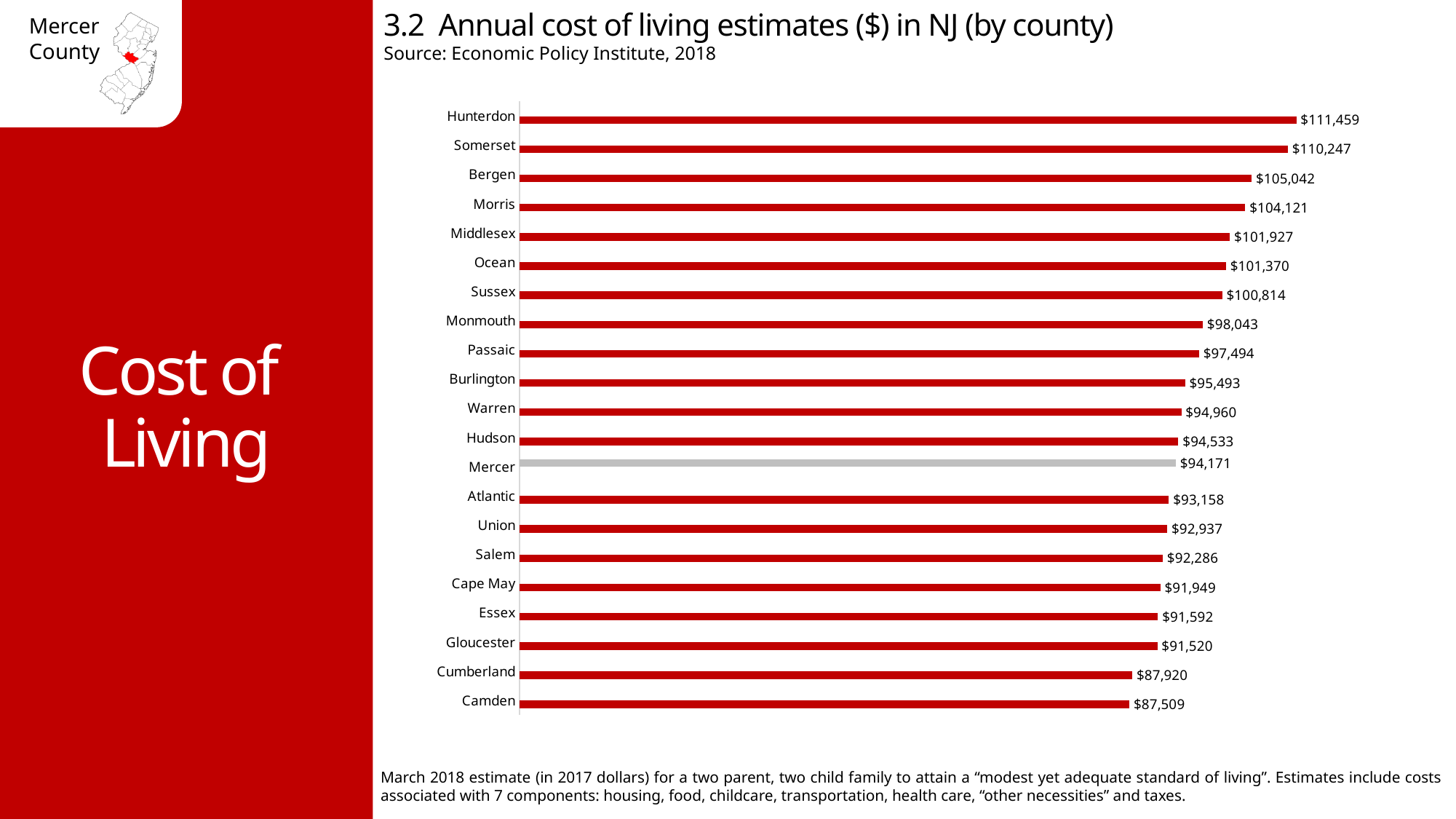
Which county's bar is shown in gray instead of red? Mercer What is the annual cost of living estimate for Mercer County? $94,171 Which county has a higher cost of living estimate, Ocean or Monmouth? Ocean Which county has the lowest annual cost of living estimate? Camden What is the difference between the cost of living estimates for Hunterdon and Camden? $23,950 What is the difference between the cost of living estimates for Hudson and Mercer? $362 What is the annual cost of living estimate for Bergen County? $105,042 How many counties are shown in the chart? 21 Which county has the highest annual cost of living estimate? Hunterdon What kind of chart is shown on the slide? Bar chart What is the source cited for the chart? Economic Policy Institute, 2018 What is the annual cost of living estimate for Cumberland County? $87,920